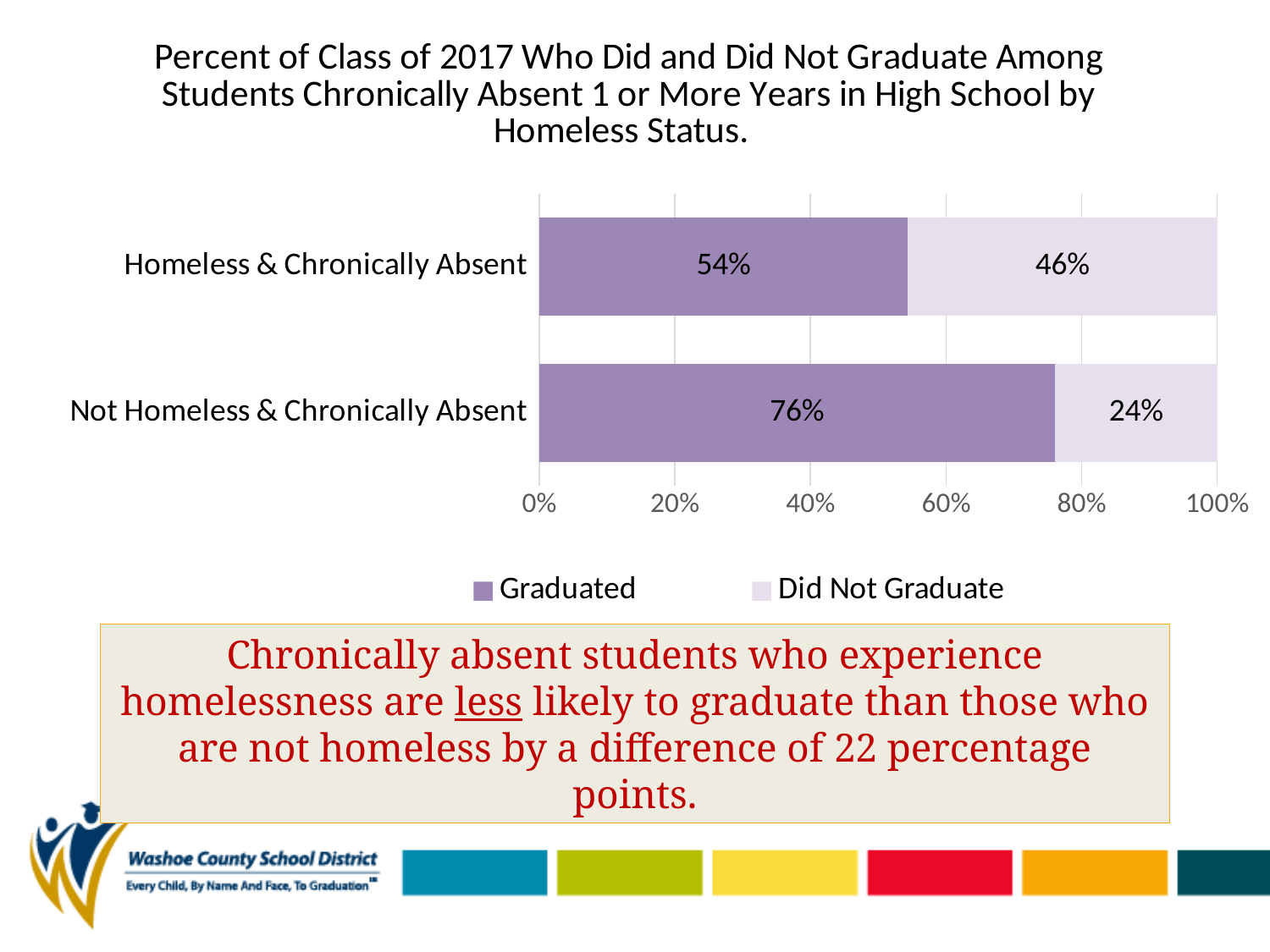
What kind of chart is shown on the slide? Stacked bar chart How many categories are shown on the chart? 2 What percentage of Homeless & Chronically Absent students did not graduate? 46% Is the Graduated value for Homeless & Chronically Absent greater or less than 60%? less What is the total of the stacked bar for Not Homeless & Chronically Absent? 100% Which category has the lower Did Not Graduate percentage? Not Homeless & Chronically Absent What is the difference in Graduated percentage between Not Homeless & Chronically Absent and Homeless & Chronically Absent students? 22 percentage points What percentage of Not Homeless & Chronically Absent students did not graduate? 24% How many series does the legend list? 2 Is the Did Not Graduate value for Homeless & Chronically Absent larger or smaller than the Did Not Graduate value for Not Homeless & Chronically Absent? larger Which category has the higher Graduated percentage? Not Homeless & Chronically Absent What percentage of Homeless & Chronically Absent students graduated? 54%